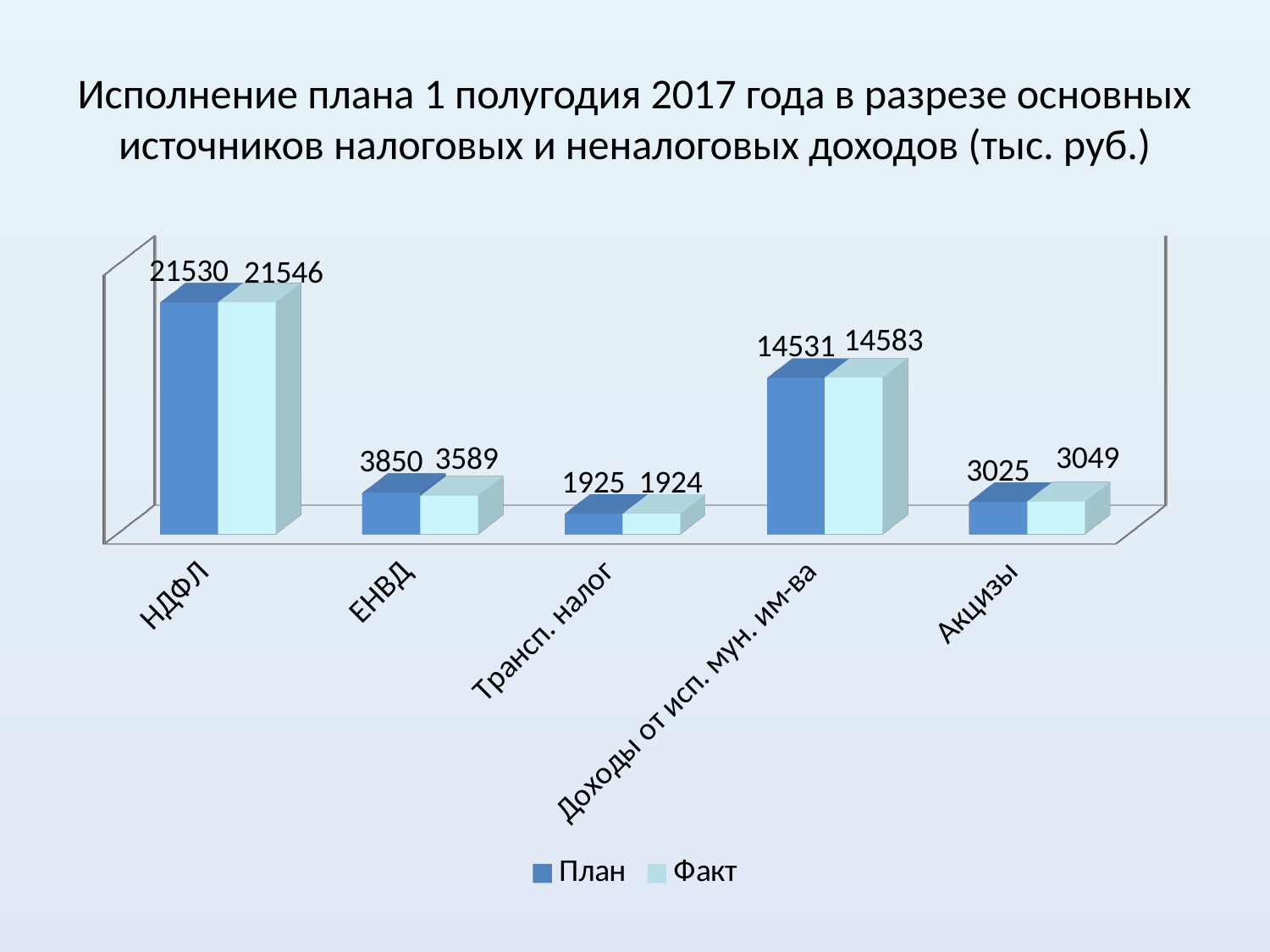
What is the difference between the План and Факт values for ЕНВД? 261 What is the План value for Акцизы? 3025 What is the Факт value for ЕНВД? 3589 Which is larger for Акцизы, the План value or the Факт value? Факт What is the Факт value for Доходы от исп. мун. им-ва? 14583 What is the План value for НДФЛ? 21530 How many categories are shown on the x axis? 5 Which category has the highest Факт value? НДФЛ How many series does the legend list? 2 What kind of chart is shown on the slide? Bar chart Which category has the lowest План value? Трансп. налог What is the difference between the Факт values for НДФЛ and Доходы от исп. мун. им-ва? 6963